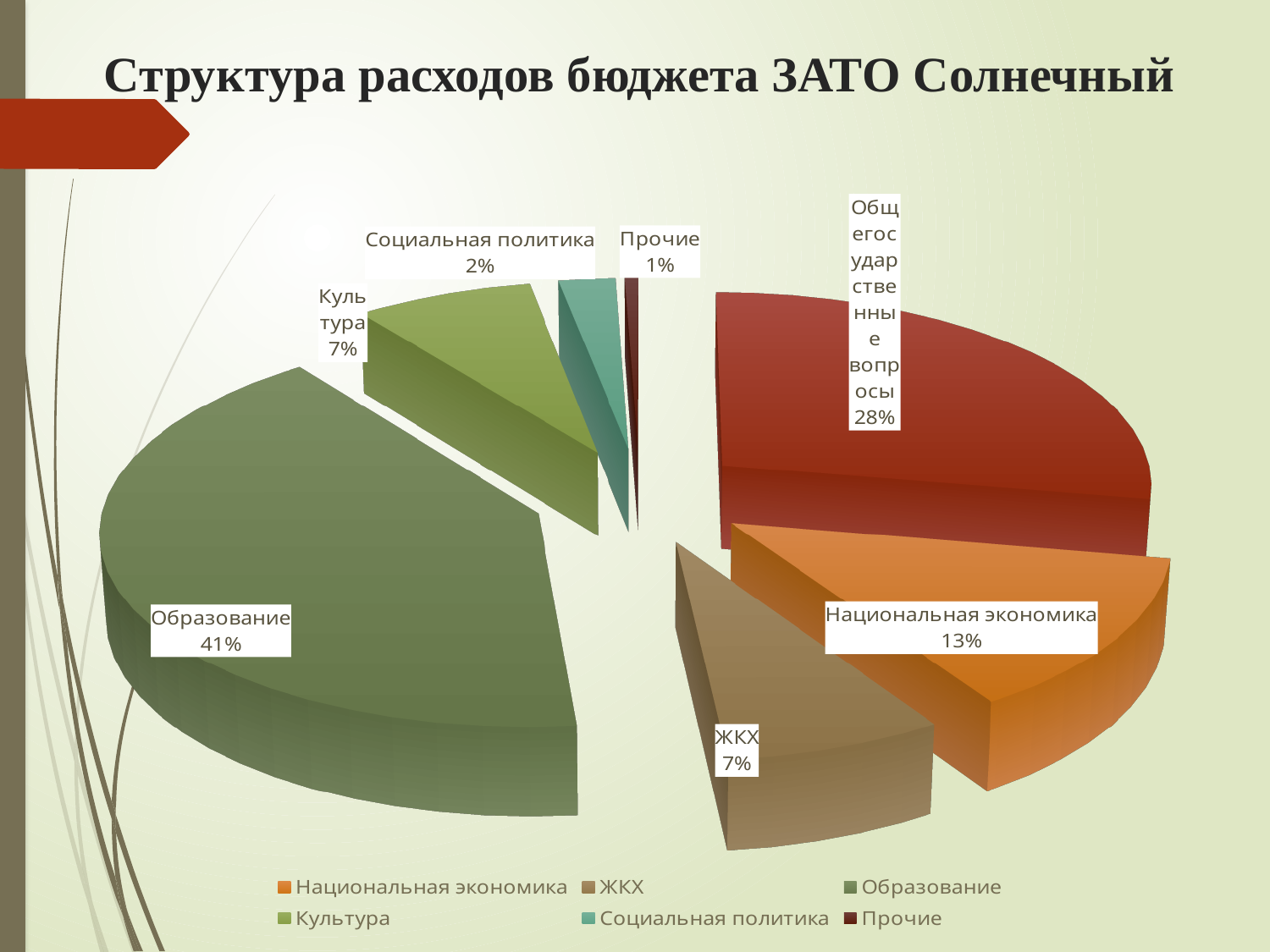
How many slices does the pie chart have? 7 What is the title of the chart on the slide? Структура расходов бюджета ЗАТО Солнечный What share of the budget expenditure goes to Прочие? 1% What is the difference in percentage points between Образование and Общегосударственные вопросы? 13 What share of the budget expenditure goes to Образование? 41% Which category has the largest share of the budget expenditure? Образование What share of the budget expenditure goes to Национальная экономика? 13% Which category has the smallest share of the budget expenditure? Прочие What share of the budget expenditure goes to Социальная политика? 2% Which is larger, the share for Национальная экономика or the share for ЖКХ? Национальная экономика What share of the budget expenditure goes to Общегосударственные вопросы? 28% What type of chart is shown on the slide? pie chart